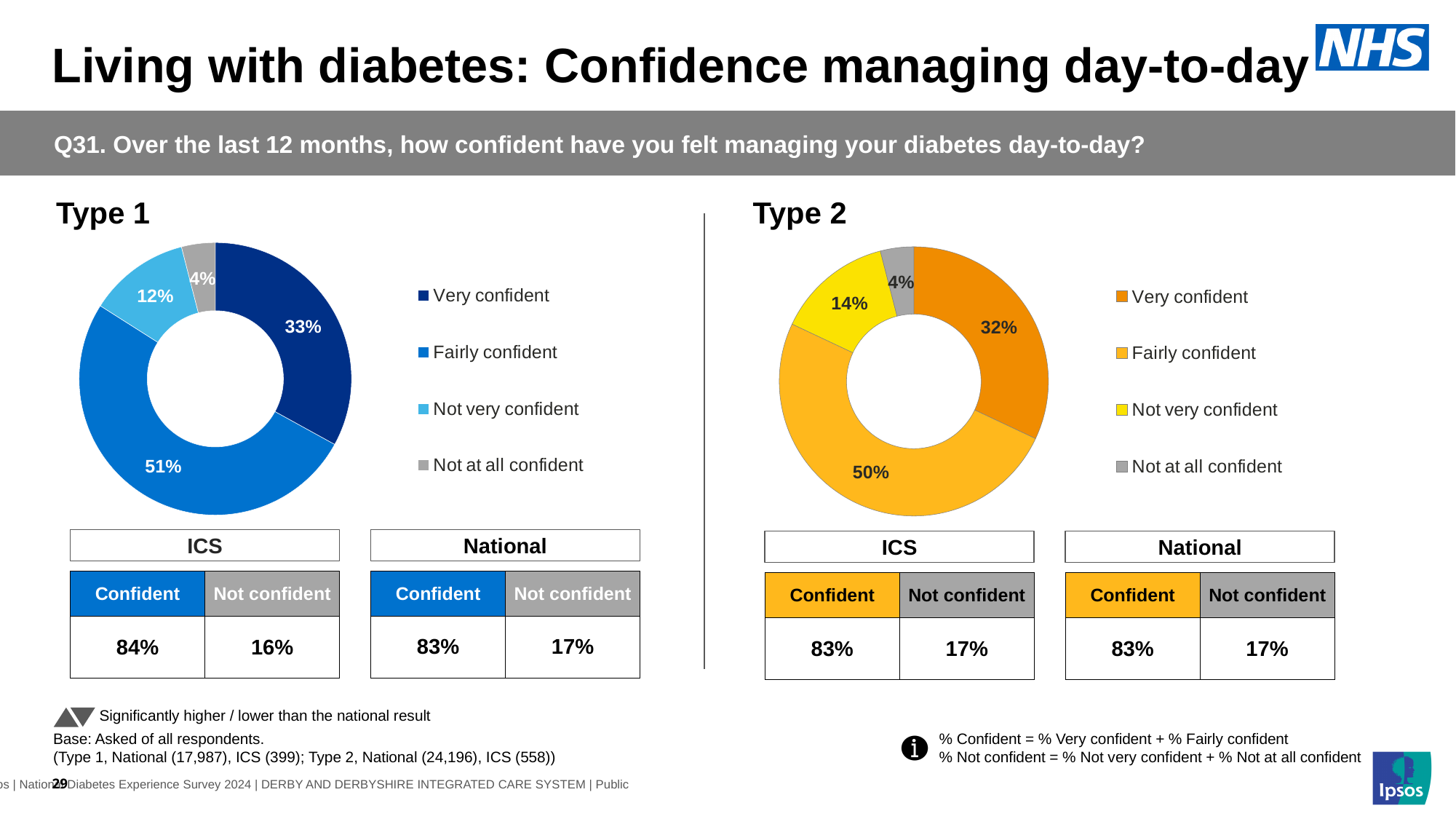
In the Type 1 chart, what percentage of respondents were not very confident? 12% In the Type 1 chart, which category has the smallest share? Not at all confident In the Type 2 chart, which category has the largest share? Fairly confident How many categories does the Type 1 chart show? 4 In the Type 1 chart, what percentage of respondents were very confident? 33% How many entries does the legend of the Type 2 chart list? 4 Which is larger: the not very confident share in the Type 1 chart or in the Type 2 chart? Type 2 In the Type 2 chart, what is the difference between the not very confident and not at all confident shares? 10% In the Type 2 chart, what colour is the very confident slice? Orange In the Type 1 chart, what is the difference between the fairly confident and very confident shares? 18% What kind of chart is used for Type 1? Pie (donut) chart In the Type 2 chart, what percentage of respondents were fairly confident? 50%